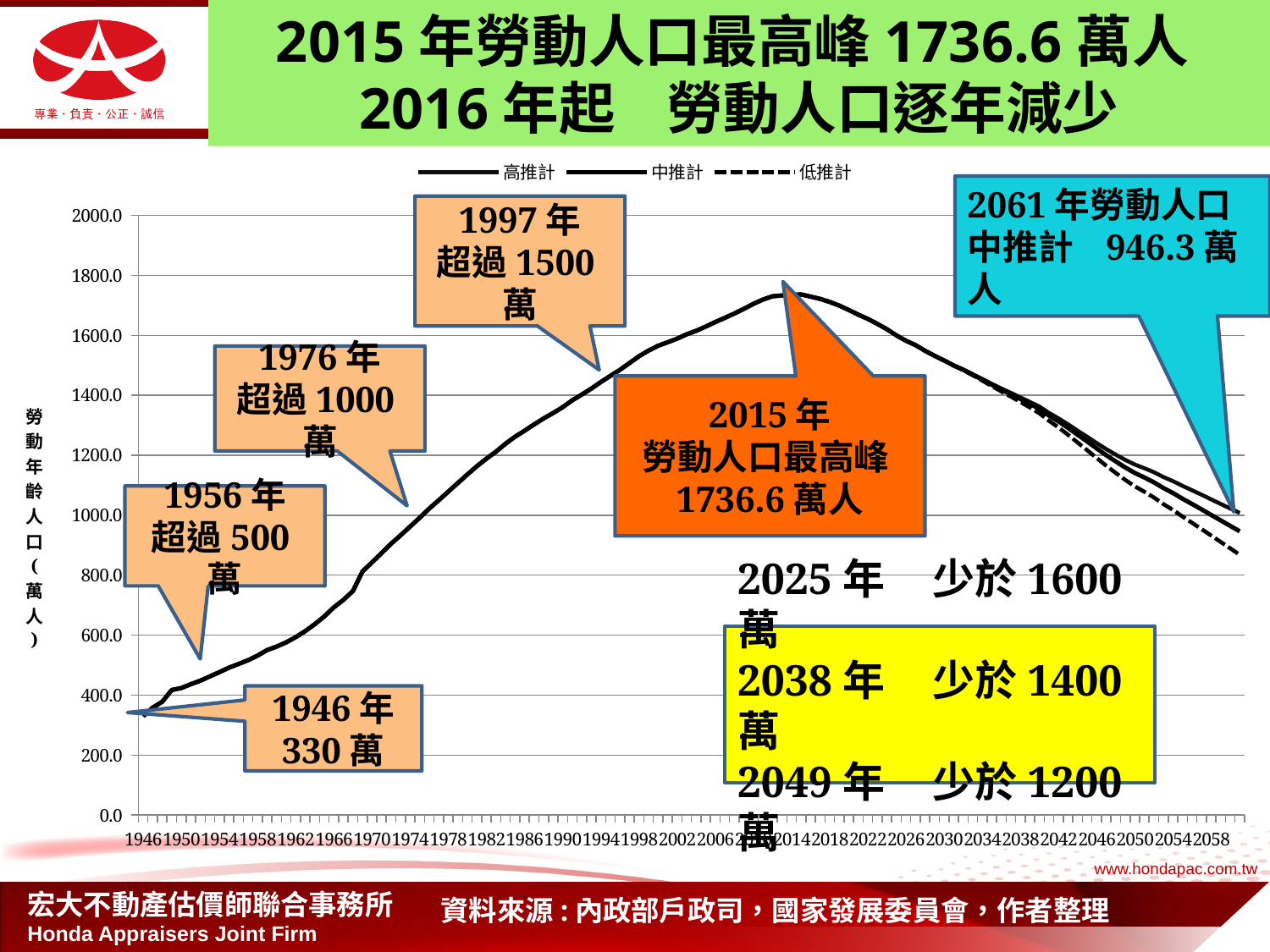
What kind of chart is shown on the slide? line chart What is the peak labour population value labelled for 2015? 1736.6 萬人 How many series does the legend list? 3 In which year does the labour population reach its peak according to the chart? 2015 年 What is the difference between the 2015 peak (1736.6 萬人) and the 2061 中推計 value (946.3 萬人)? 790.3 萬人 What is the 中推計 labour population value labelled for 2061? 946.3 萬人 Is the labour population value for 2025 greater or less than 1600? less What labour population value is labelled for 1946? 330 萬 Does the labour population rise or fall along the x axis from 1946 to 2015? rise Is the labour population value for 1956 greater or less than 400? greater Which series is lowest at the right end of the chart (around 2058)? 低推計 What are the three series named in the legend? 高推計, 中推計, 低推計